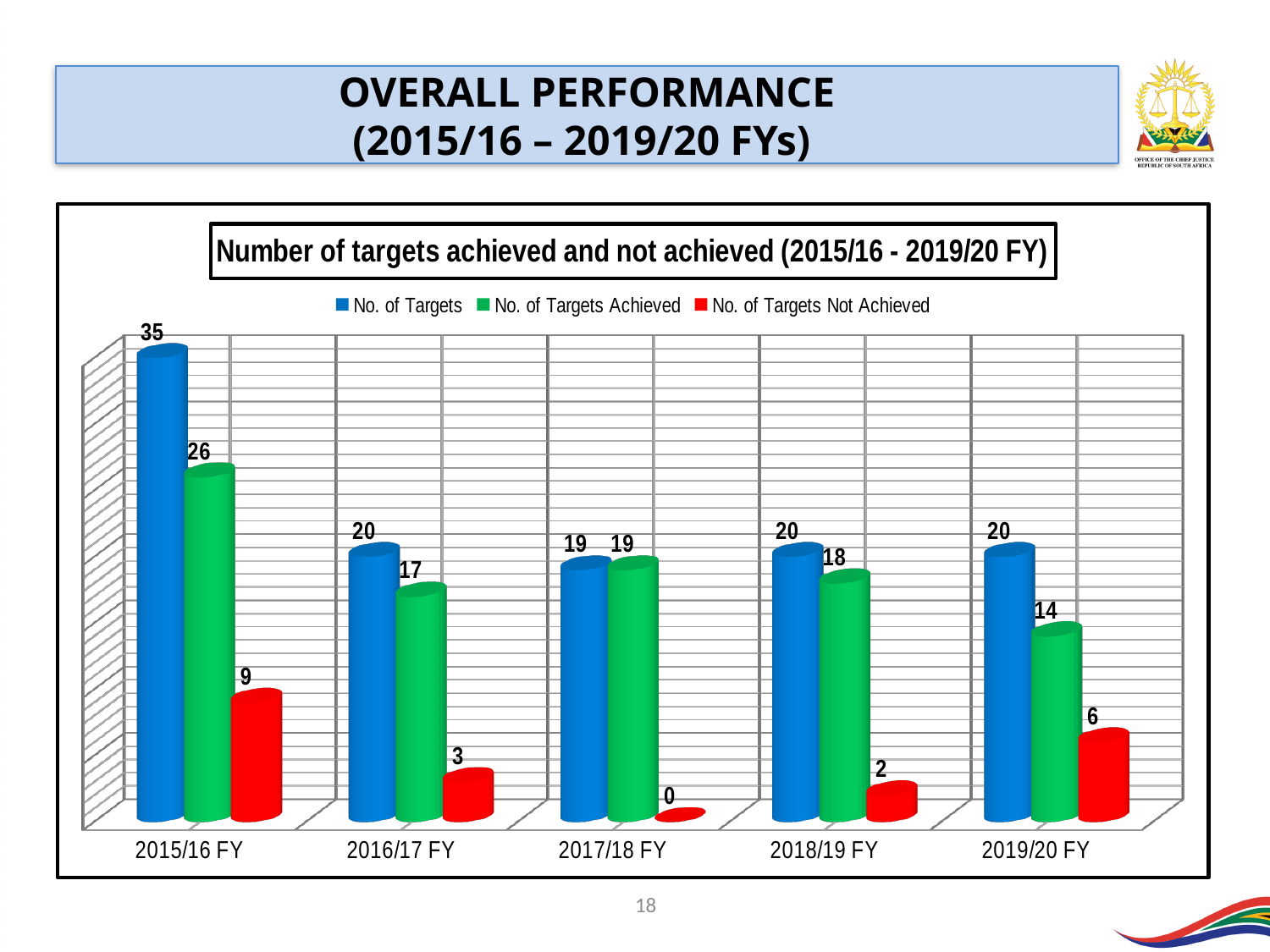
What is the difference between the number of targets and the number of targets achieved in 2019/20 FY? 6 Which financial year has the highest number of targets? 2015/16 FY What is the number of targets not achieved in 2019/20 FY? 6 How many series does the legend list? 3 Which is larger: the number of targets achieved in 2016/17 FY or in 2018/19 FY? 2018/19 FY What kind of chart is shown on the slide? Bar chart Which financial year has the lowest number of targets not achieved? 2017/18 FY What colour represents the 'No. of Targets Not Achieved' series? Red How many financial years are shown on the x axis? 5 What is the number of targets achieved in 2015/16 FY? 26 Does the number of targets not achieved rise or fall from 2015/16 FY to 2017/18 FY? Fall What is the number of targets in 2017/18 FY? 19